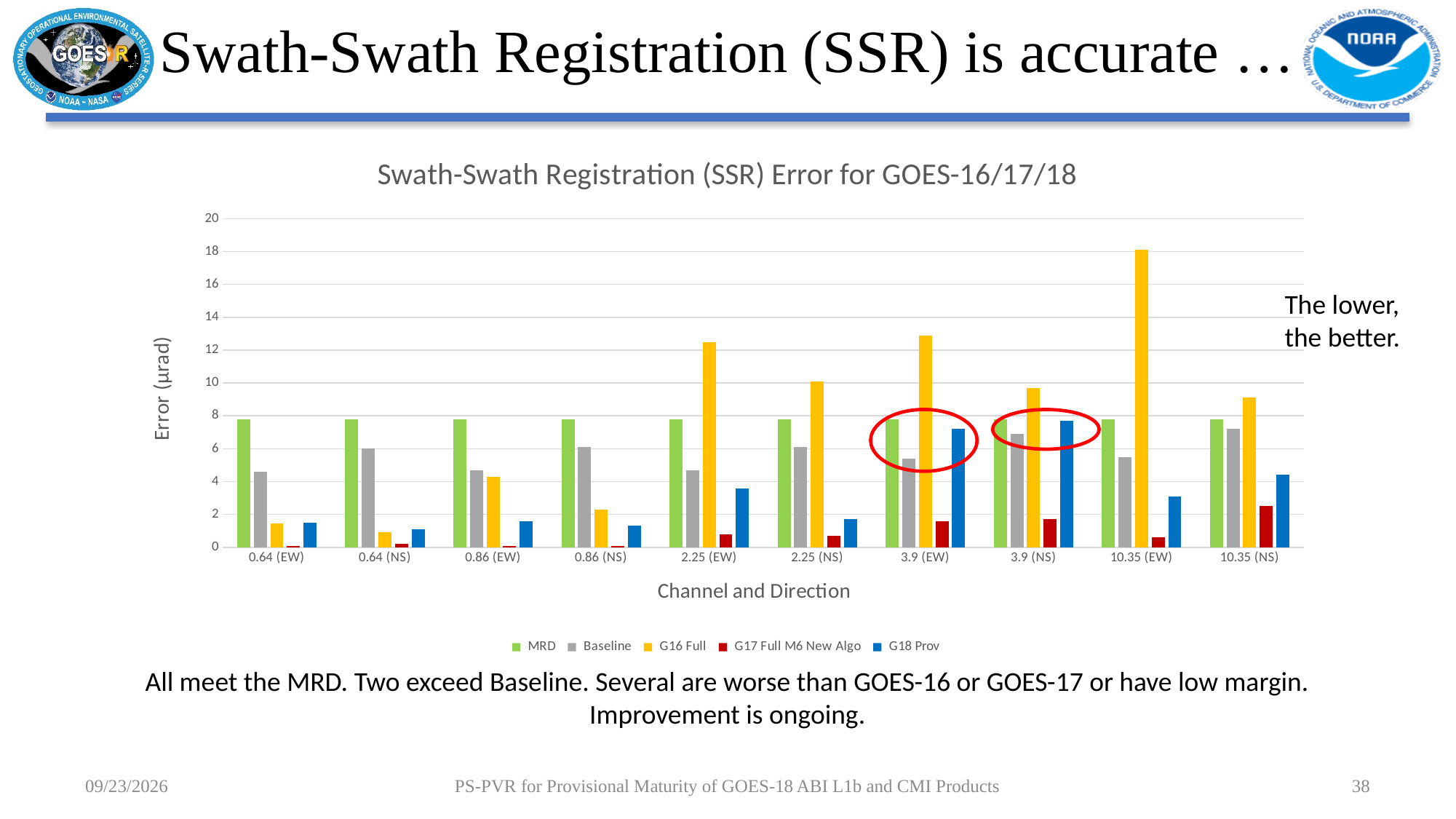
Is the G16 Full value for 2.25 (EW) greater or less than 10? greater Is the G16 Full value for 10.35 (EW) greater or less than 16? greater Is the G17 Full M6 New Algo value for 10.35 (NS) greater or less than 4? less How many channel-and-direction categories are shown on the x axis? 10 What is the label of the y axis? Error (µrad) What type of chart is shown on the slide? Bar chart For which category is the G16 Full value highest? 10.35 (EW) What is the title of the chart? Swath-Swath Registration (SSR) Error for GOES-16/17/18 How many series does the chart legend list? 5 For 2.25 (NS), which is larger: the G16 Full value or the G18 Prov value? G16 Full For 3.9 (EW), which is larger: the G18 Prov value or the Baseline value? G18 Prov